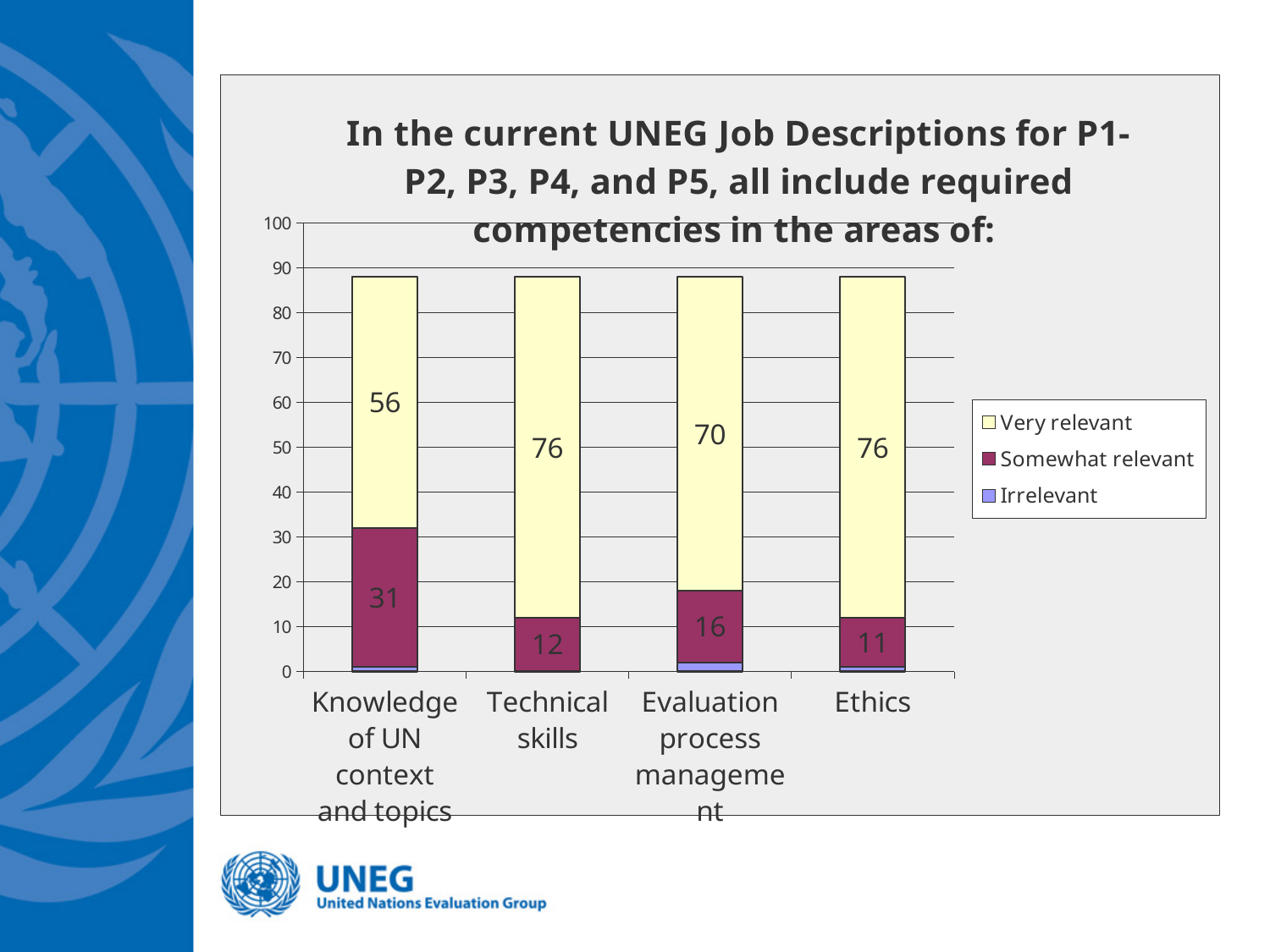
How many series does the legend list? 3 Which category has the highest 'Somewhat relevant' value? Knowledge of UN context and topics Which category has the lowest 'Very relevant' value? Knowledge of UN context and topics What is the 'Somewhat relevant' value for Ethics? 11 What is the 'Somewhat relevant' value for Knowledge of UN context and topics? 31 What is the 'Very relevant' value for Technical skills? 76 How many categories are shown on the x axis? 4 Which is larger: the 'Somewhat relevant' value for Evaluation process management or for Technical skills? Evaluation process management What is the 'Very relevant' value for Evaluation process management? 70 What is the difference between the 'Very relevant' values for Ethics and Knowledge of UN context and topics? 20 Is the 'Irrelevant' value for Evaluation process management greater or less than 10? less What kind of chart is shown on the slide? Stacked bar chart